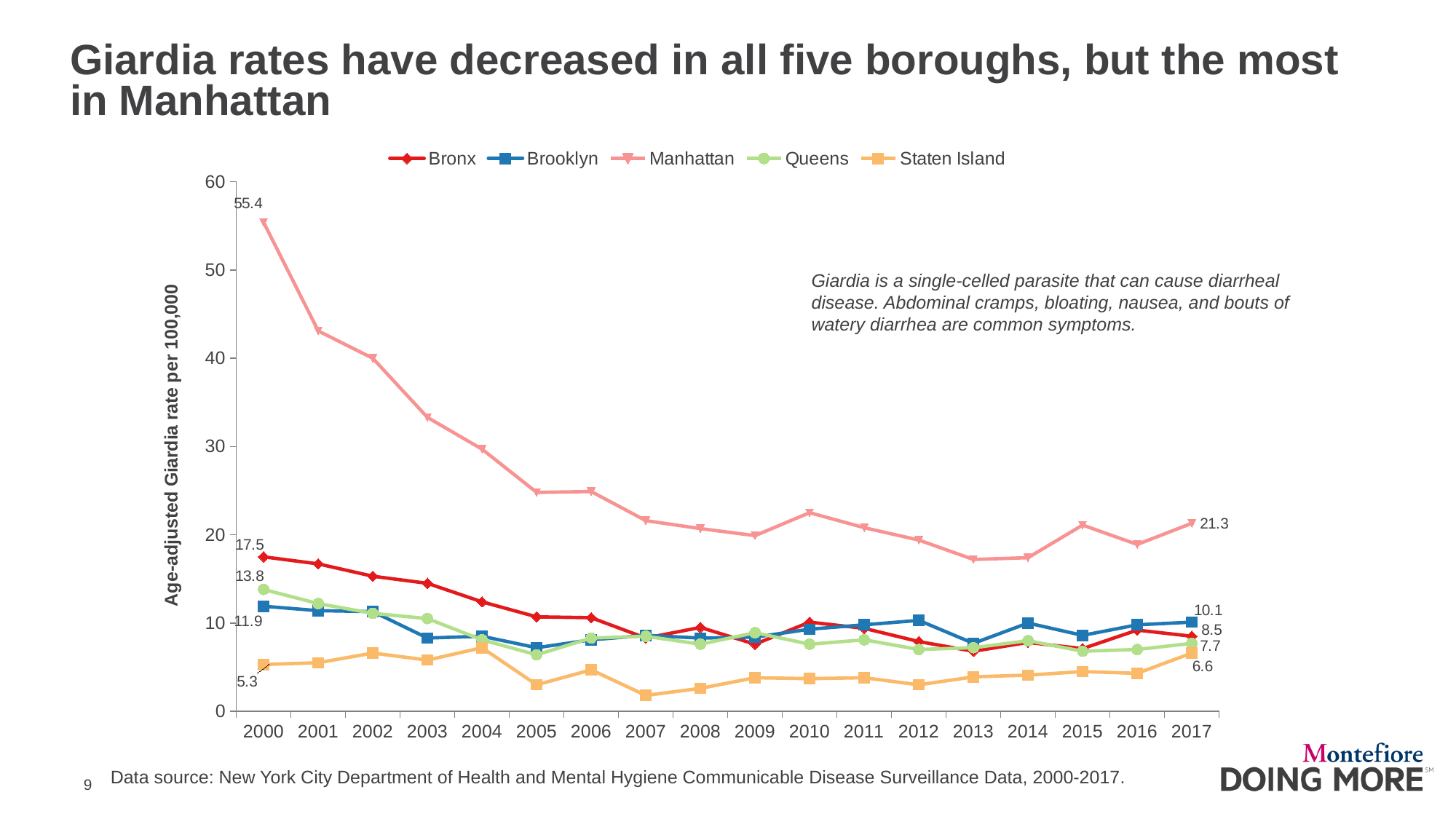
How many years are shown on the x axis? 18 What was the Manhattan Giardia rate in 2000? 55.4 What type of chart is shown on the slide? line chart By how much did the Manhattan Giardia rate fall from 2000 to 2017? 34.1 What was the Staten Island Giardia rate in 2000? 5.3 Which borough had the lowest Giardia rate in 2017? Staten Island How many series does the legend list? 5 What was the Manhattan Giardia rate in 2017? 21.3 Which borough had the highest Giardia rate in 2000? Manhattan Which was larger in 2000, the Bronx rate or the Queens rate? Bronx What was the Brooklyn Giardia rate in 2017? 10.1 Is the Manhattan Giardia rate in 2005 greater or less than 30? less